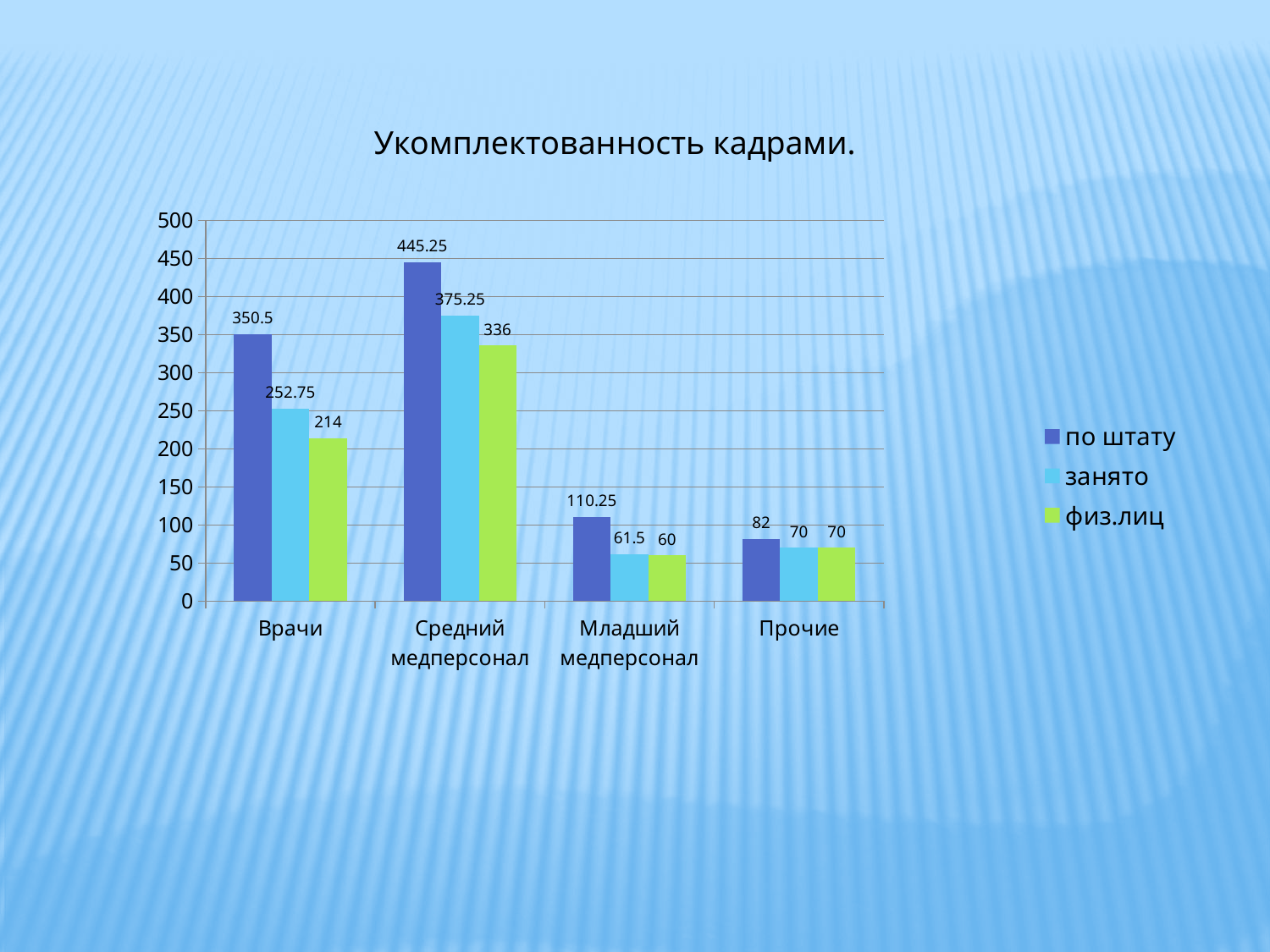
What is the value for "занято" in the "Средний медперсонал" category? 375.25 Which category has the lowest value for "занято"? Младший медперсонал What is the difference between "занято" and "физ.лиц" for "Средний медперсонал"? 39.25 What is the value for "по штату" in the "Врачи" category? 350.5 How many categories are shown on the x axis? 4 What kind of chart is shown on the slide? bar chart What is the difference between "по штату" and "занято" for "Врачи"? 97.75 What is the title of the chart? Укомплектованность кадрами. How many series does the legend list? 3 What is the value for "физ.лиц" in the "Младший медперсонал" category? 60 Which category has the highest value for "по штату"? Средний медперсонал Which is larger for "Прочие": "по штату" or "занято"? по штату